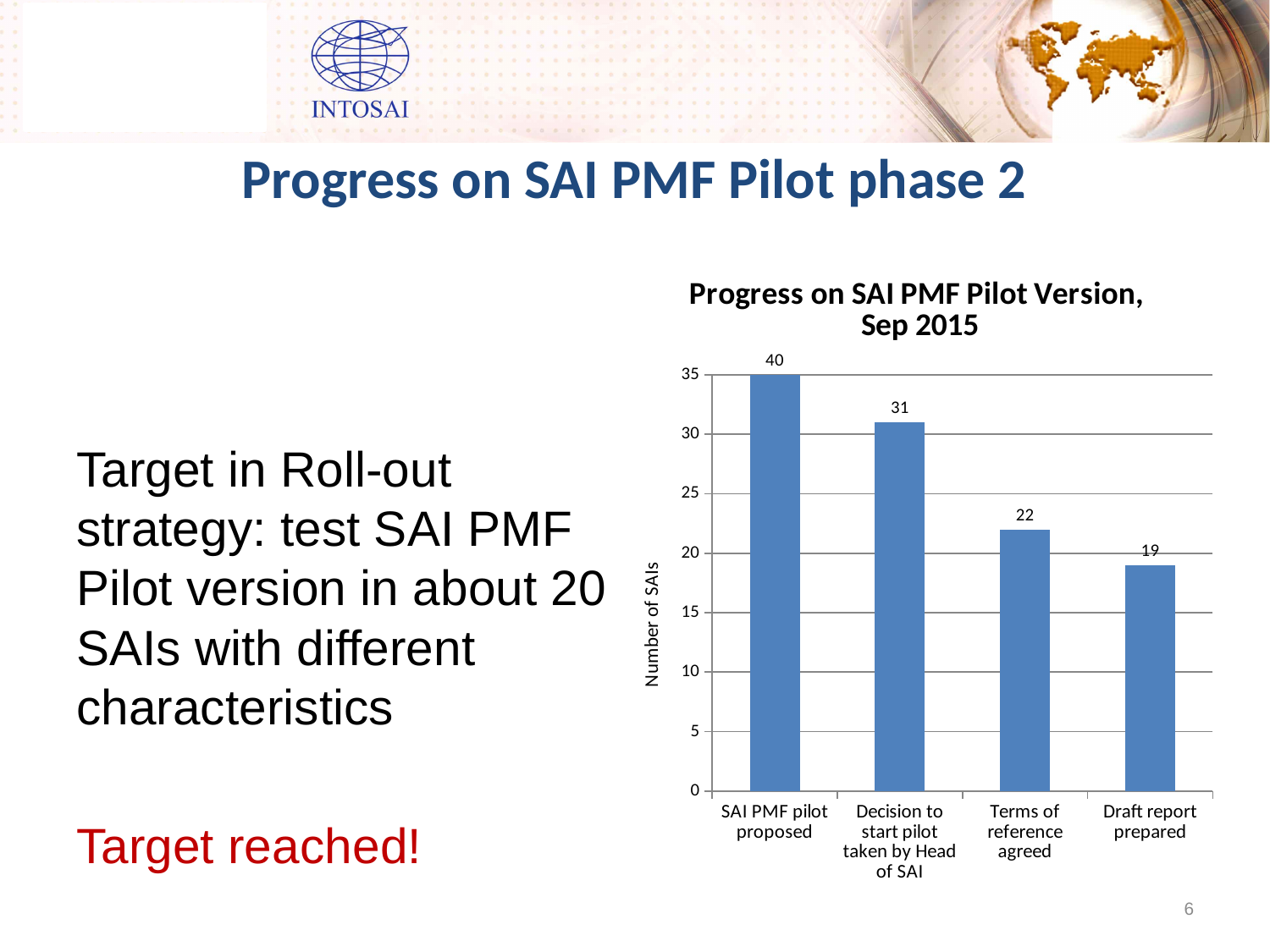
Do the values rise or fall from left to right along the x axis? fall Which category has the highest number of SAIs? SAI PMF pilot proposed How many categories are shown on the x axis? 4 What is the value for "Terms of reference agreed"? 22 Which is larger: "Decision to start pilot taken by Head of SAI" or "Terms of reference agreed"? Decision to start pilot taken by Head of SAI What is the title of the chart? Progress on SAI PMF Pilot Version, Sep 2015 Which category has the lowest number of SAIs? Draft report prepared What kind of chart is shown? bar chart What is the value for "Draft report prepared"? 19 What is the difference between "SAI PMF pilot proposed" and "Draft report prepared"? 21 What is the value for "SAI PMF pilot proposed"? 40 What is the value for "Decision to start pilot taken by Head of SAI"? 31